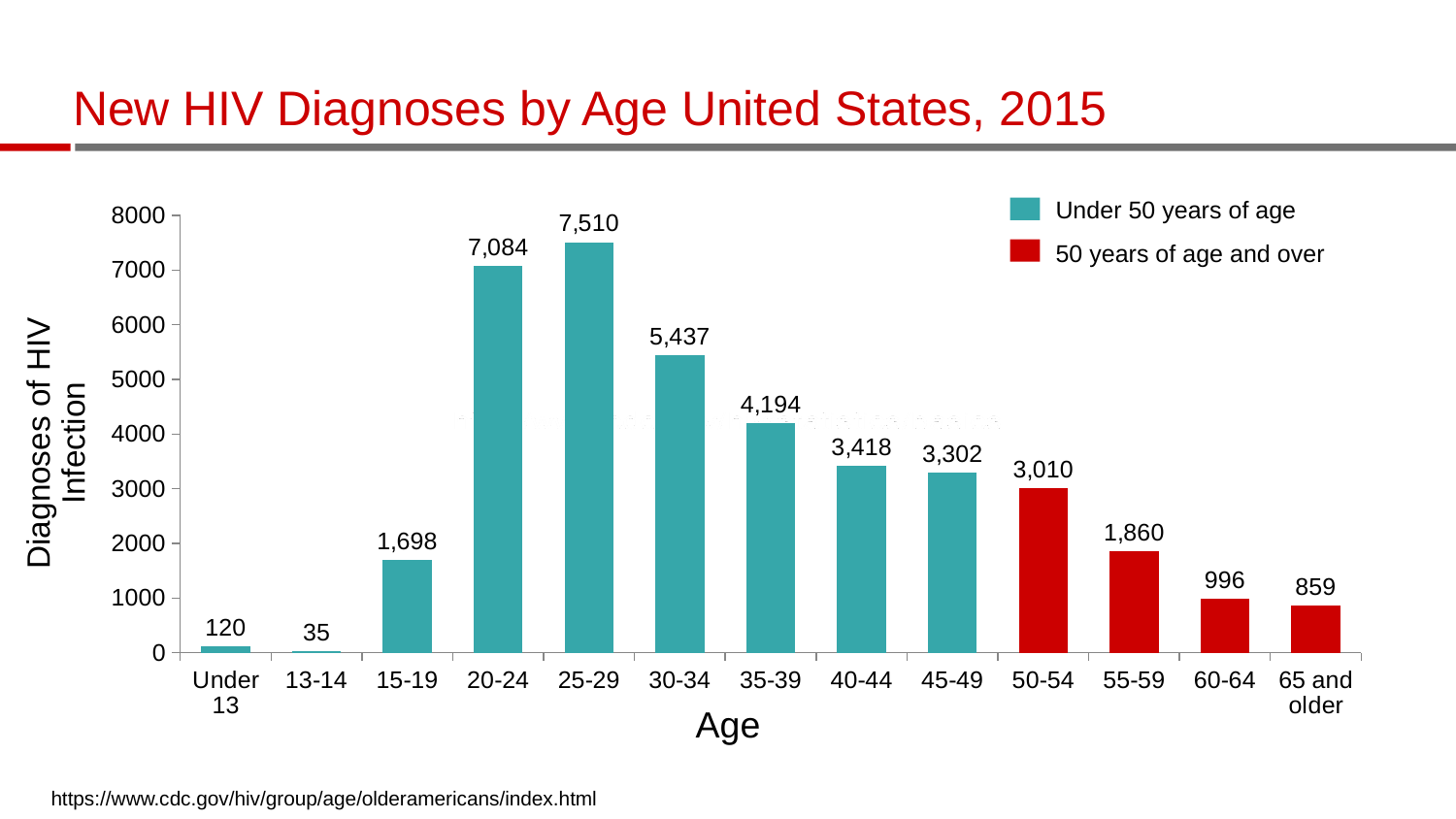
Which age group has more new HIV diagnoses, 40-44 or 55-59? 40-44 Which age group has the lowest number of new HIV diagnoses? 13-14 Which age group has the highest number of new HIV diagnoses? 25-29 What is the difference in new HIV diagnoses between the 20-24 and 30-34 age groups? 1,647 What is the number of new HIV diagnoses for the 50-54 age group? 3,010 What colour are the bars for the '50 years of age and over' series? Red How many series does the legend list? 2 Is the value for the 35-39 age group greater or less than 4000? greater What is the number of new HIV diagnoses for the 13-14 age group? 35 How many age groups are shown on the x axis? 13 What is the number of new HIV diagnoses for the 25-29 age group? 7,510 What kind of chart is shown on the slide? Bar chart